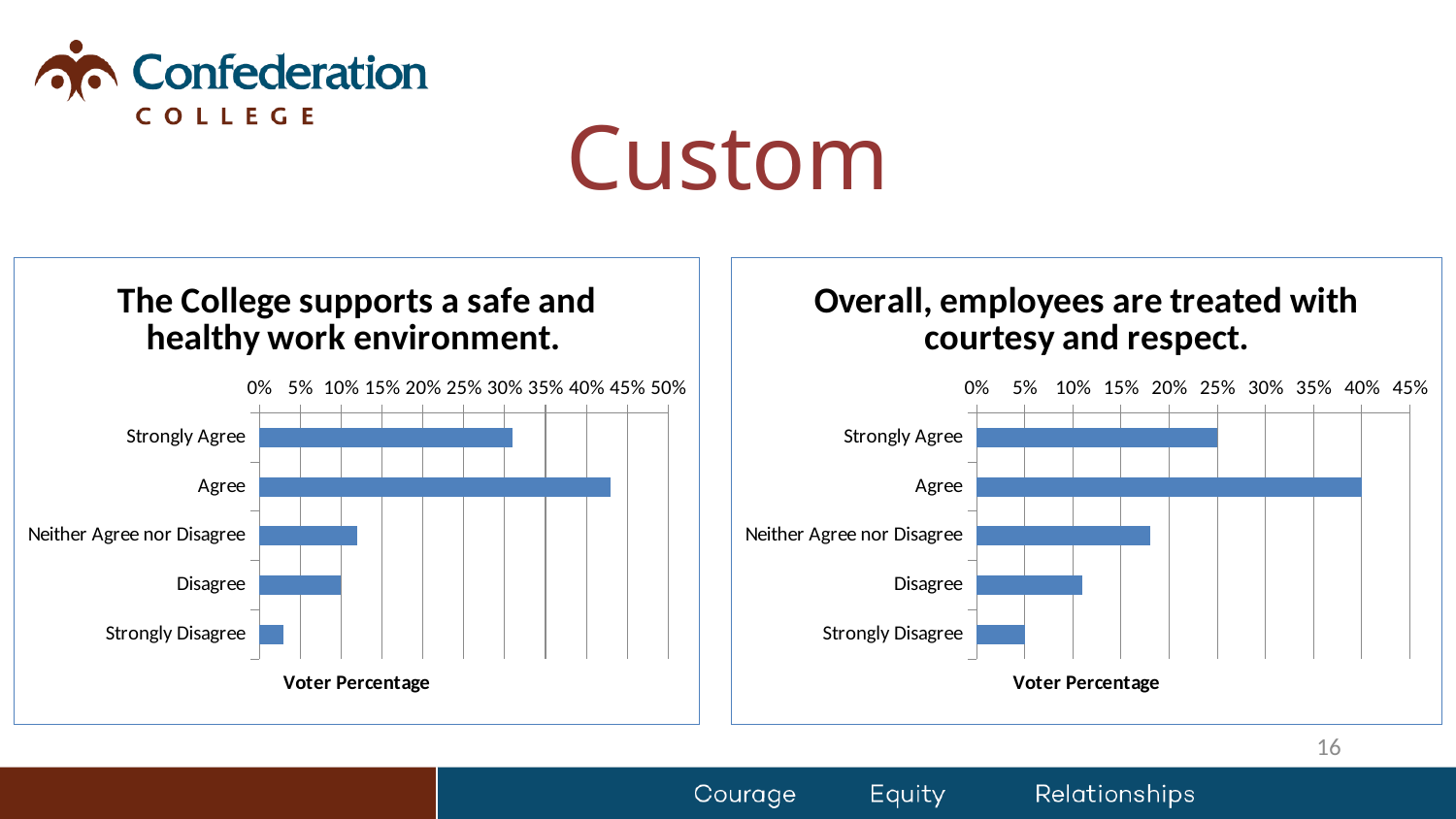
In the chart 'The College supports a safe and healthy work environment.', is the value for Strongly Disagree greater or less than 5%? less In the chart 'Overall, employees are treated with courtesy and respect.', is the value for Neither Agree nor Disagree greater or less than 15%? greater What type of chart is used in 'The College supports a safe and healthy work environment.'? bar chart In the chart 'Overall, employees are treated with courtesy and respect.', which is larger, Strongly Agree or Neither Agree nor Disagree? Strongly Agree In the chart 'The College supports a safe and healthy work environment.', which category has the lowest value? Strongly Disagree In the chart 'Overall, employees are treated with courtesy and respect.', which category has the highest value? Agree In the chart 'Overall, employees are treated with courtesy and respect.', which category has the lowest value? Strongly Disagree In the chart 'The College supports a safe and healthy work environment.', is the value for Agree greater or less than 40%? greater In the chart 'The College supports a safe and healthy work environment.', which category has the highest value? Agree How many categories are shown in the chart 'The College supports a safe and healthy work environment.'? 5 What is the x-axis title of the chart 'Overall, employees are treated with courtesy and respect.'? Voter Percentage